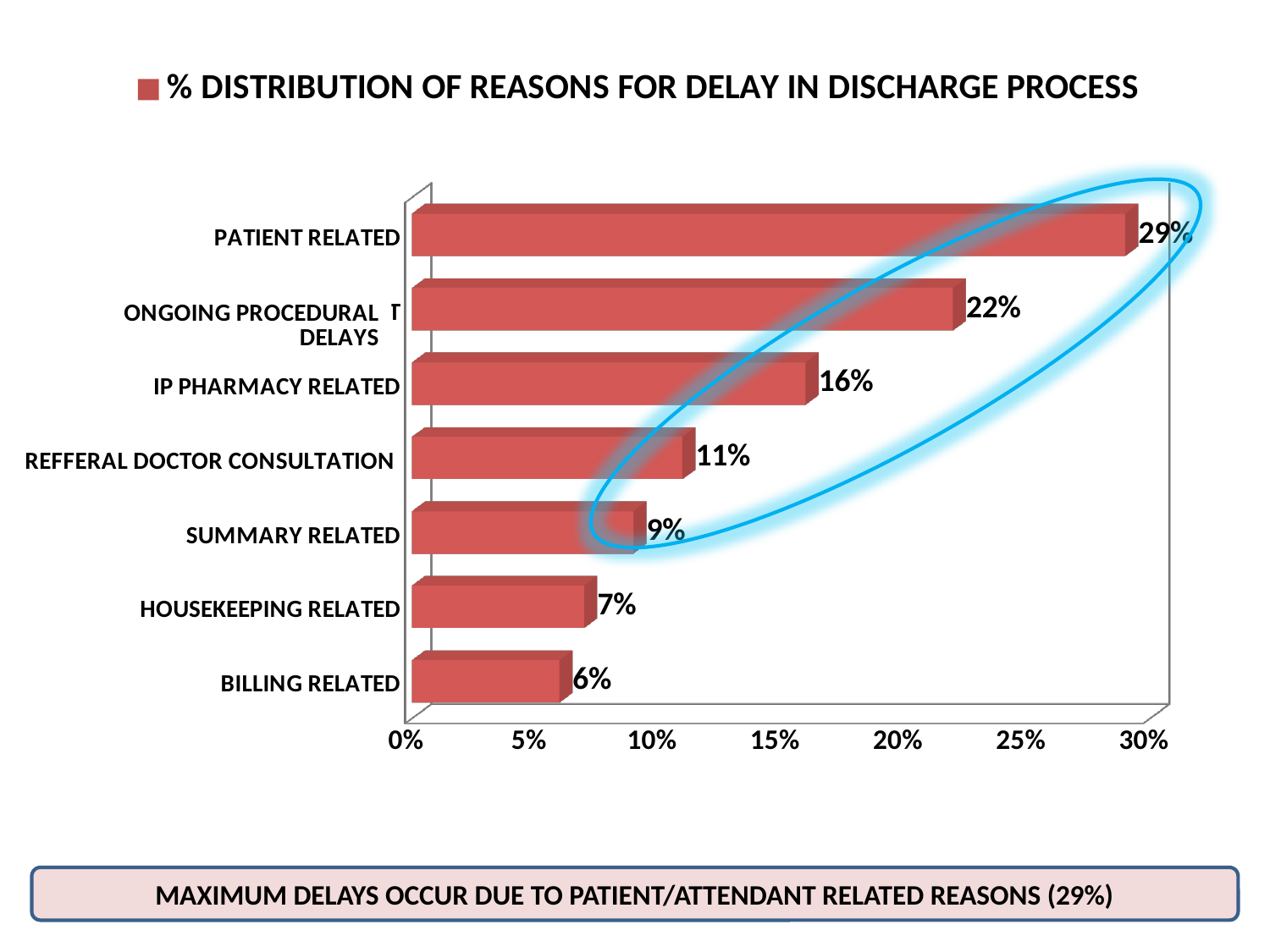
Is the value for ONGOING PROCEDURAL DELAYS greater or less than 20%? greater What is the value for IP PHARMACY RELATED? 16% What is the value for PATIENT RELATED? 29% Which category has the lowest value? BILLING RELATED What is the difference between the values for SUMMARY RELATED and BILLING RELATED? 3% What kind of chart is shown on the slide? bar chart Which is larger, the value for REFFERAL DOCTOR CONSULTATION or the value for SUMMARY RELATED? REFFERAL DOCTOR CONSULTATION Which category has the highest value? PATIENT RELATED What is the title of the chart? % DISTRIBUTION OF REASONS FOR DELAY IN DISCHARGE PROCESS What is the value for HOUSEKEEPING RELATED? 7% What is the difference between the values for PATIENT RELATED and ONGOING PROCEDURAL DELAYS? 7% How many categories are shown in the chart? 7